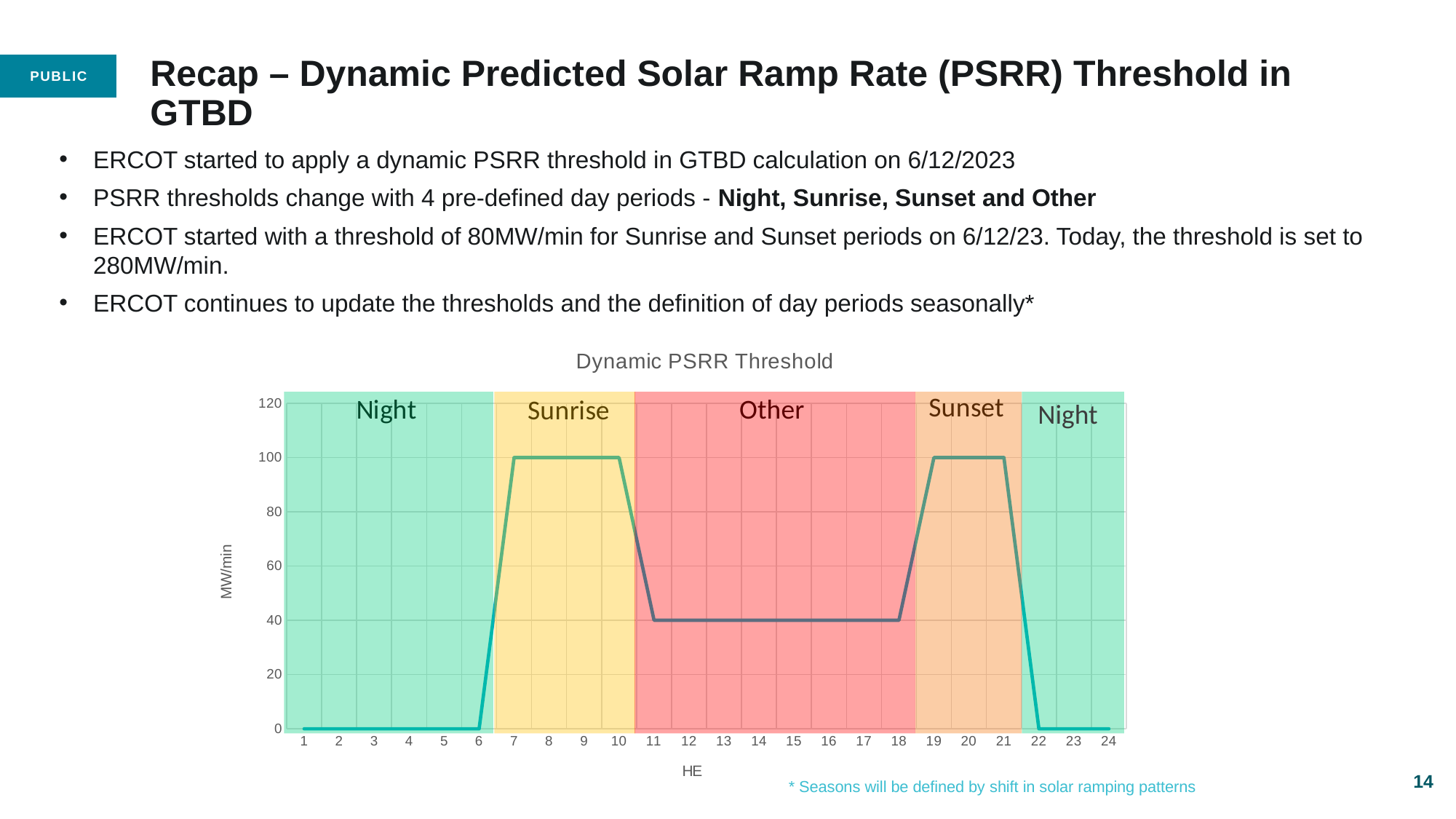
What is the threshold value at HE 20? 100 What kind of chart is shown on the slide? line chart How many hour-ending (HE) points are shown on the x axis? 24 What is the y-axis label of the chart? MW/min What is the threshold value at HE 14? 40 Is the threshold value at HE 16 greater or less than 60? less Which is larger, the threshold at HE 12 or the threshold at HE 19? HE 19 What is the difference between the threshold at HE 9 and the threshold at HE 15? 60 What is the threshold value at HE 3? 0 What is the threshold value at HE 8? 100 Does the threshold rise or fall between HE 10 and HE 11? fall What is the title of the chart? Dynamic PSRR Threshold